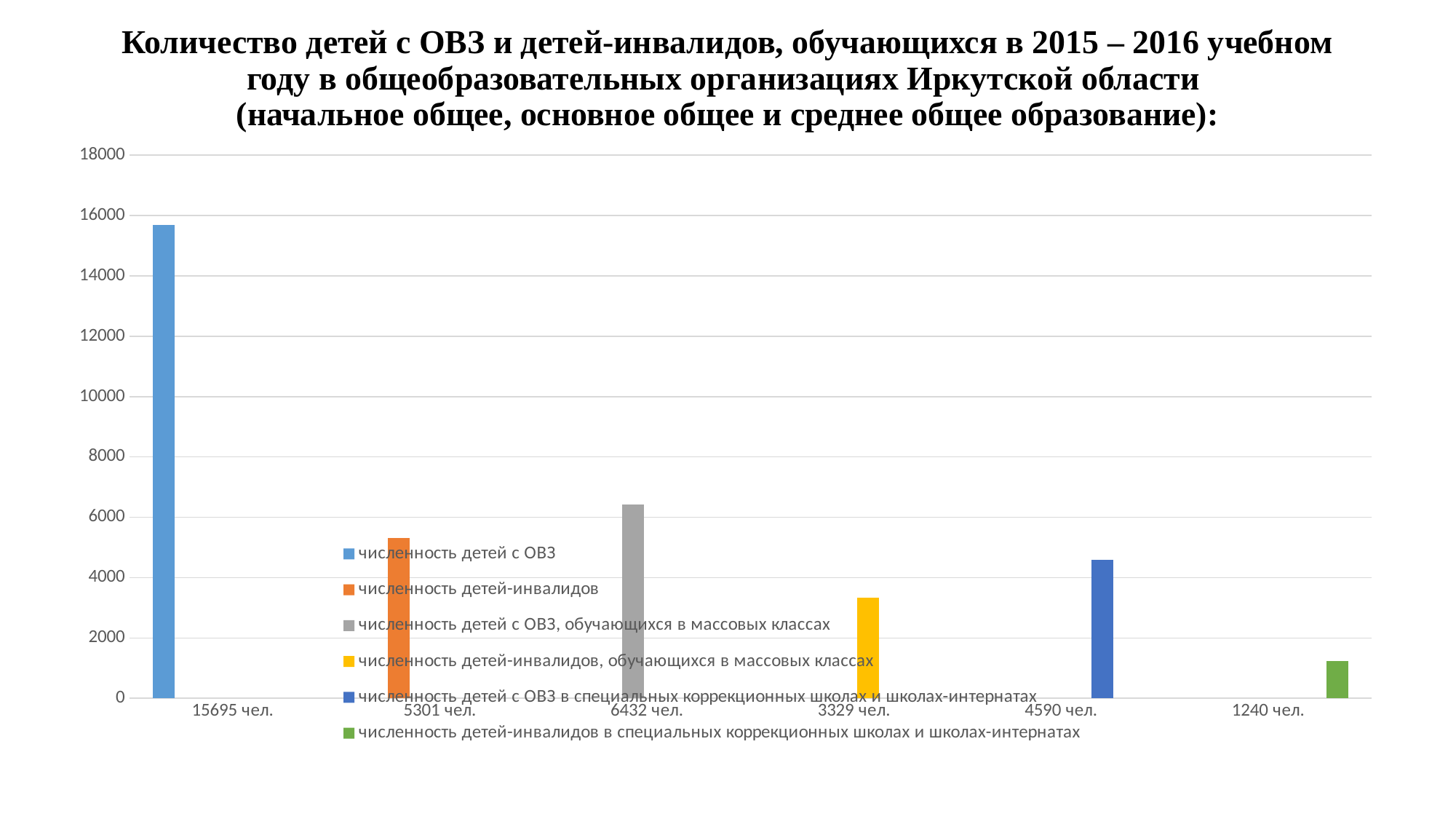
How many bars are plotted on the chart? 6 What is the value shown for "численность детей с ОВЗ, обучающихся в массовых классах" (the gray bar)? 6432 чел. Is the value for "численность детей с ОВЗ" greater or less than 14000? greater What kind of chart is shown on the slide? bar chart What is the value shown for "численность детей-инвалидов" (the orange bar)? 5301 чел. Which series has the lowest value on the chart? численность детей-инвалидов в специальных коррекционных школах и школах-интернатах Which series has the highest value on the chart? численность детей с ОВЗ What is the value shown for "численность детей-инвалидов в специальных коррекционных школах и школах-интернатах" (the green bar)? 1240 чел. What is the value shown for "численность детей с ОВЗ" (the blue bar)? 15695 чел. How many series does the legend list? 6 What is the difference between the value for "численность детей с ОВЗ, обучающихся в массовых классах" (6432 чел.) and "численность детей-инвалидов, обучающихся в массовых классах" (3329 чел.)? 3103 чел. Which is larger: the value for "численность детей с ОВЗ в специальных коррекционных школах и школах-интернатах" or the value for "численность детей-инвалидов"? численность детей-инвалидов